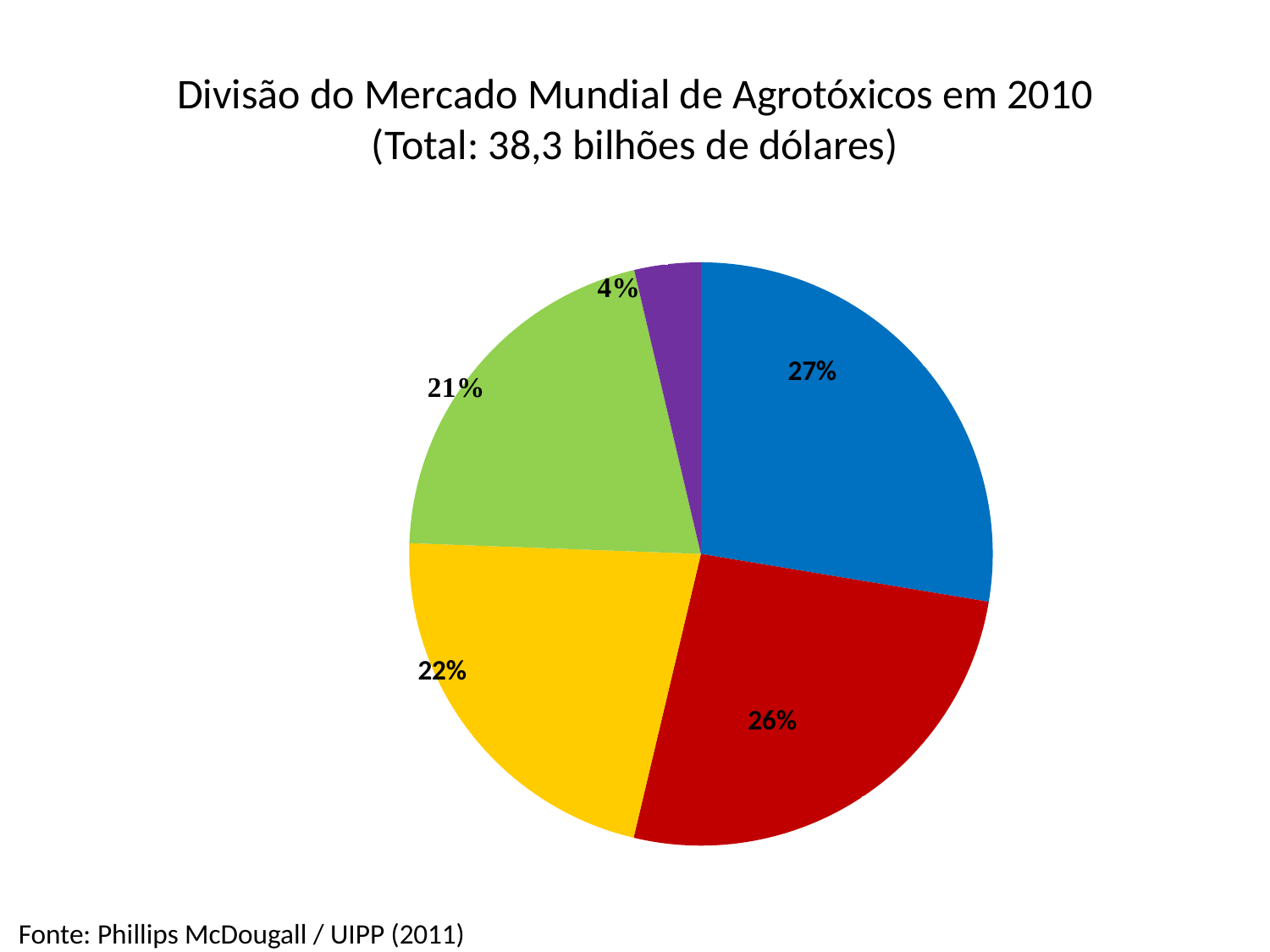
What percentage is shown on the yellow slice? 22% What is the title of the chart? Divisão do Mercado Mundial de Agrotóxicos em 2010 (Total: 38,3 bilhões de dólares) What percentage is shown on the purple slice? 4% What percentage is shown on the red slice? 26% What percentage is shown on the green slice? 21% How many slices does the pie chart have? 5 What kind of chart is shown on the slide? pie chart What source is cited below the chart? Phillips McDougall / UIPP (2011) What percentage is shown on the blue slice? 27% Which colour slice has the largest share of the pie? blue Which colour slice has the smallest share of the pie? purple What is the difference in percentage points between the blue slice and the purple slice? 23